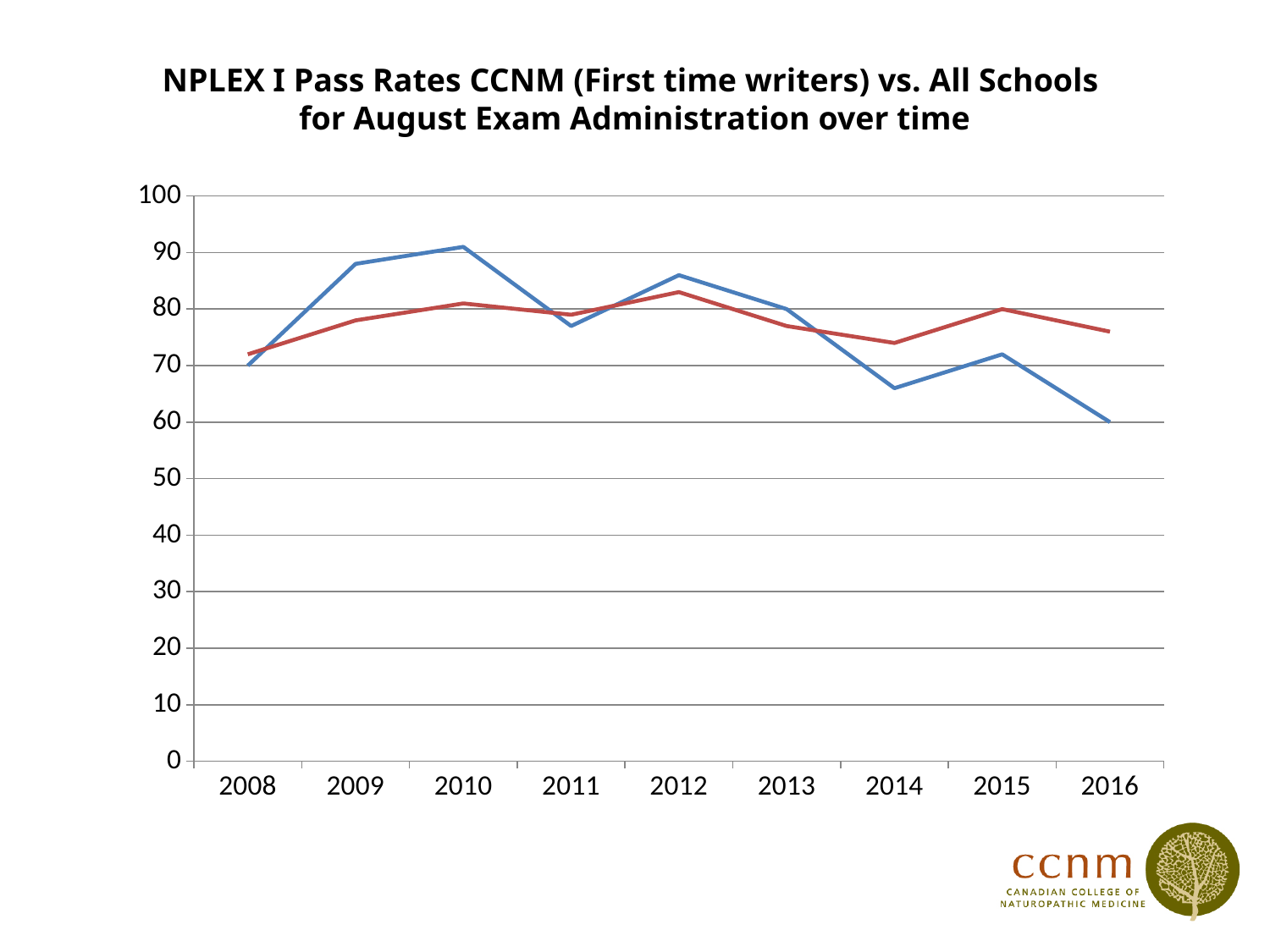
Is the value of the blue line in 2009 greater or less than 80? greater How many lines are plotted on the chart? 2 What is the title of the chart? NPLEX I Pass Rates CCNM (First time writers) vs. All Schools for August Exam Administration over time How many years are plotted along the x axis? 9 Is the value of the red line in 2012 greater or less than 80? greater In 2015, which line has the higher value, the blue line or the red line? red line Is the value of the blue line in 2014 greater or less than 70? less Does the red line rise or fall from 2008 to 2010? rise What kind of chart is shown on the slide? line chart In which year does the blue line reach its highest value? 2010 In 2009, which line has the higher value, the blue line or the red line? blue line In which year does the blue line reach its lowest value? 2016